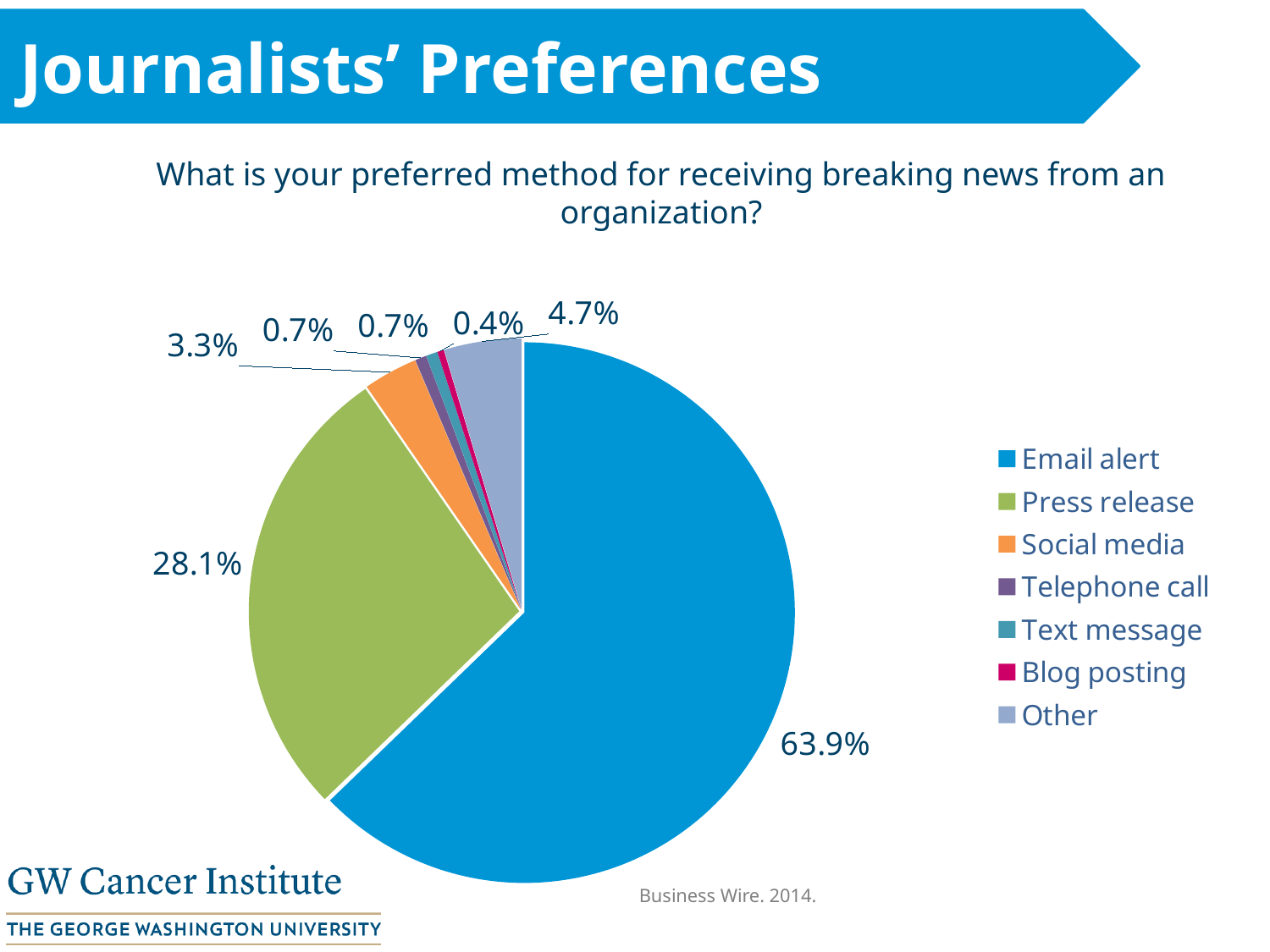
What question is the pie chart answering, according to the text above it? What is your preferred method for receiving breaking news from an organization? How many categories does the legend list? 7 Which preferred method has the largest share of the pie? Email alert What percentage of journalists prefer Press release? 28.1% What percentage is shown for Other? 4.7% Which preferred method has the smallest share of the pie? Blog posting What percentage is shown for Social media? 3.3% Which has a larger share, Other or Social media? Other What percentage of journalists prefer Email alert for receiving breaking news? 63.9% What percentage is shown for Blog posting? 0.4% What kind of chart is shown on the slide? Pie chart What is the difference in percentage points between Email alert and Press release? 35.8